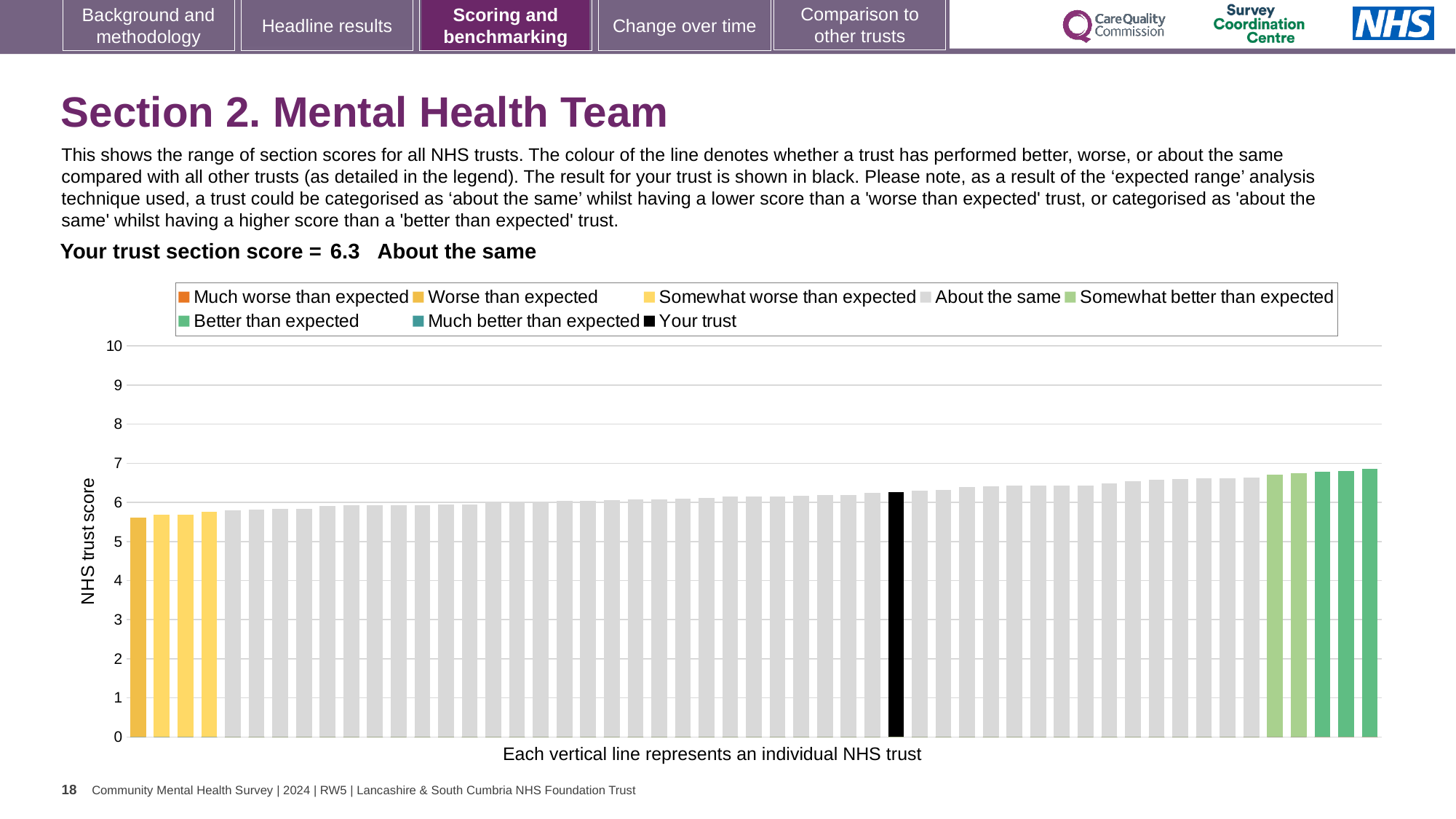
How many entries does the chart legend list? 8 Is the value of the highest bar on the chart greater or less than 7? less What kind of chart is shown on the slide? bar chart How is your trust's section score categorised compared with other trusts? About the same What is the section score for your trust shown on the slide? 6.3 Which legend category does the lowest bar on the chart belong to? Worse than expected What colour is used for the bar representing your trust? black Is the value of the lowest bar on the chart greater or less than 5? greater Which legend category do the highest bars on the chart belong to? Better than expected What is the label on the vertical axis of the chart? NHS trust score Do the bar values rise or fall from left to right along the x axis? rise Is the value for your trust (the black bar) greater or less than 5? greater